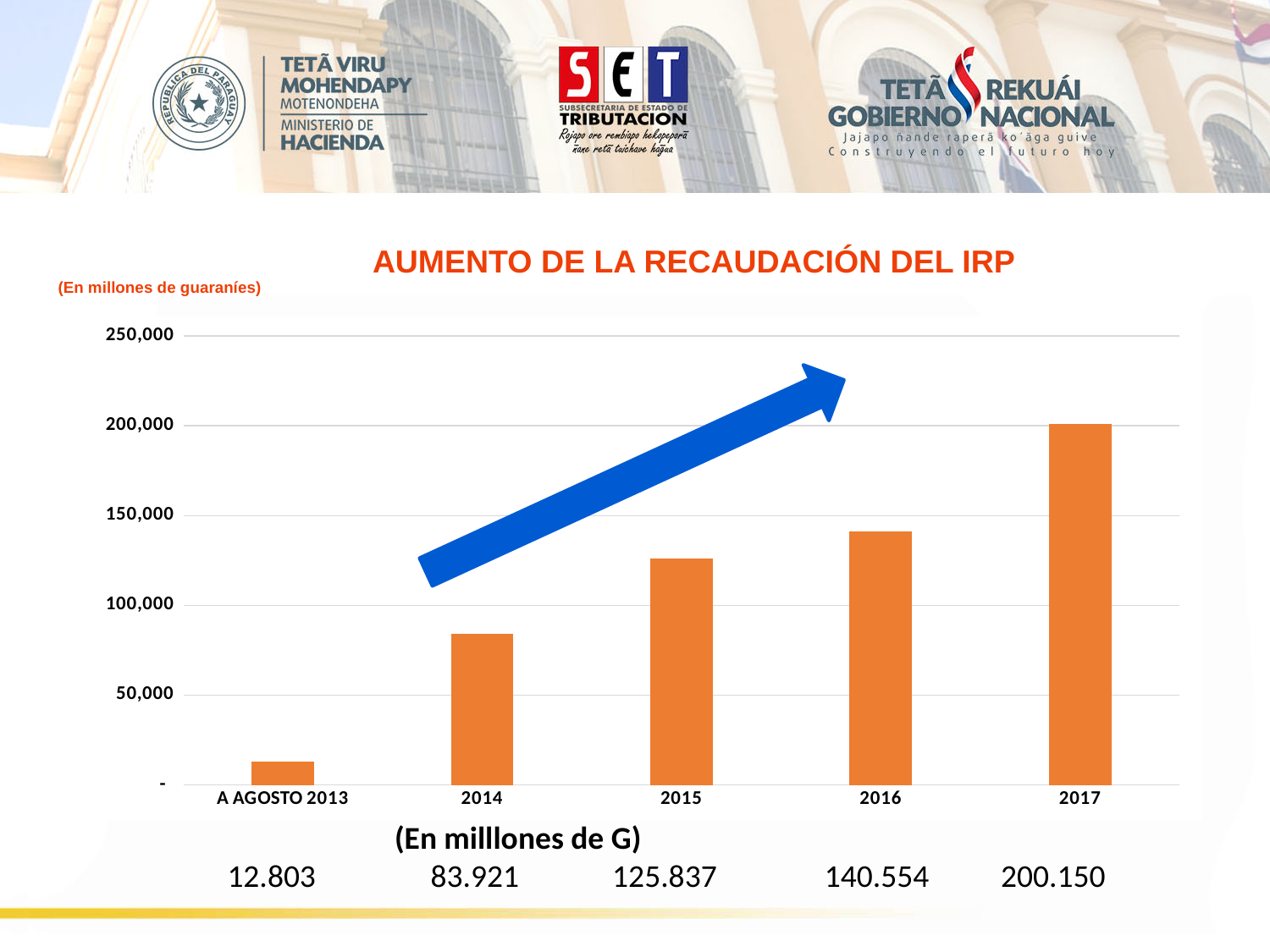
What kind of chart is shown on the slide? bar chart Which is larger, the value for 2015 or the value for 2016? 2016 What is the value for 2017? 200.150 Which category has the highest value? 2017 What is the difference between the values for 2014 and A AGOSTO 2013? 71.118 How many categories are shown on the x axis? 5 Which category has the lowest value? A AGOSTO 2013 What is the difference between the values for 2017 and 2016? 59.596 What is the value for A AGOSTO 2013? 12.803 Do the values rise or fall from A AGOSTO 2013 to 2017? rise Is the value for 2014 greater or less than 100,000? less What is the value for 2015? 125.837